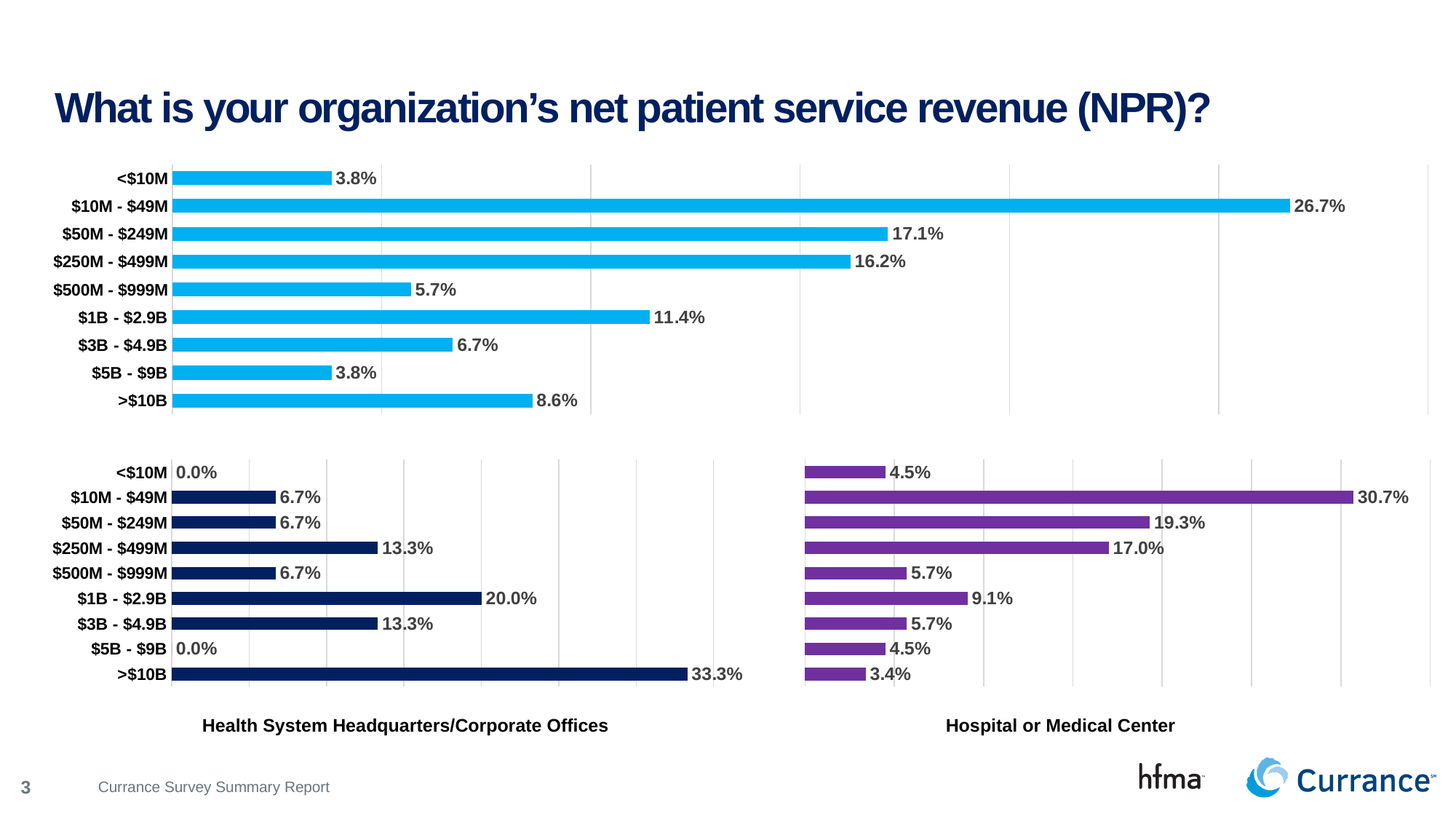
In the top chart, which is larger, the value for $1B - $2.9B or the value for >$10B? $1B - $2.9B In the Health System Headquarters/Corporate Offices chart, what is the value for >$10B? 33.3% In the top chart, which category has the highest value? $10M - $49M In the Health System Headquarters/Corporate Offices chart, which category has the highest value? >$10B In the Health System Headquarters/Corporate Offices chart, what is the value for $1B - $2.9B? 20.0% What kind of chart is the top chart? Bar chart In the Hospital or Medical Center chart, what is the difference between the values for $50M - $249M and $250M - $499M? 2.3% In the top chart, how many categories are shown? 9 In the top chart, what is the value for $10M - $49M? 26.7% In the Hospital or Medical Center chart, what is the value for $10M - $49M? 30.7% In the top chart, what is the difference between the values for $50M - $249M and $250M - $499M? 0.9% In the Hospital or Medical Center chart, which category has the lowest value? >$10B